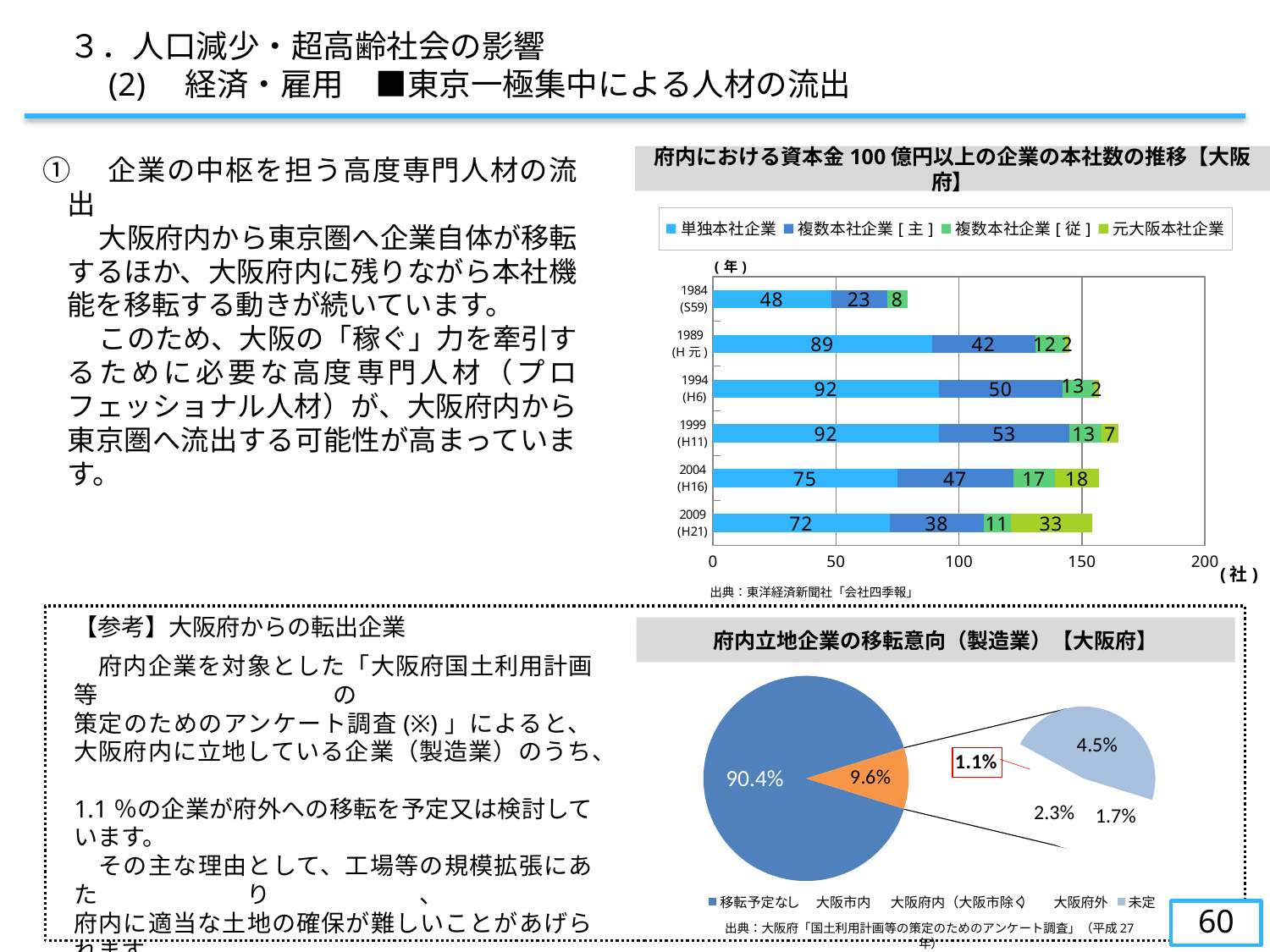
In the pie chart titled 府内立地企業の移転意向（製造業）【大阪府】, what share is shown for the largest slice? 90.4% In the pie chart titled 府内立地企業の移転意向（製造業）【大阪府】, what percentage is highlighted in the red box? 1.1% In the bar chart titled 府内における資本金100億円以上の企業の本社数の推移【大阪府】, what is the value of 複数本社企業[主] for 1999 (H11)? 53 In the bar chart titled 府内における資本金100億円以上の企業の本社数の推移【大阪府】, which year has the highest value for 元大阪本社企業? 2009 (H21) In the bar chart titled 府内における資本金100億円以上の企業の本社数の推移【大阪府】, how many series does the legend list? 4 In the bar chart titled 府内における資本金100億円以上の企業の本社数の推移【大阪府】, what is the value of 元大阪本社企業 for 2009 (H21)? 33 In the bar chart titled 府内における資本金100億円以上の企業の本社数の推移【大阪府】, what is the difference between the 単独本社企業 values for 1994 (H6) and 2009 (H21)? 20 What kind of chart is the chart titled 府内における資本金100億円以上の企業の本社数の推移【大阪府】? Stacked bar chart In the bar chart titled 府内における資本金100億円以上の企業の本社数の推移【大阪府】, which year has the lowest value for 単独本社企業? 1984 (S59) In the bar chart titled 府内における資本金100億円以上の企業の本社数の推移【大阪府】, what is the value of 単独本社企業 for 2009 (H21)? 72 In the bar chart titled 府内における資本金100億円以上の企業の本社数の推移【大阪府】, what is the total of the stacked bar for 2004 (H16)? 157 In the bar chart titled 府内における資本金100億円以上の企業の本社数の推移【大阪府】, how many years are shown on the vertical axis? 6